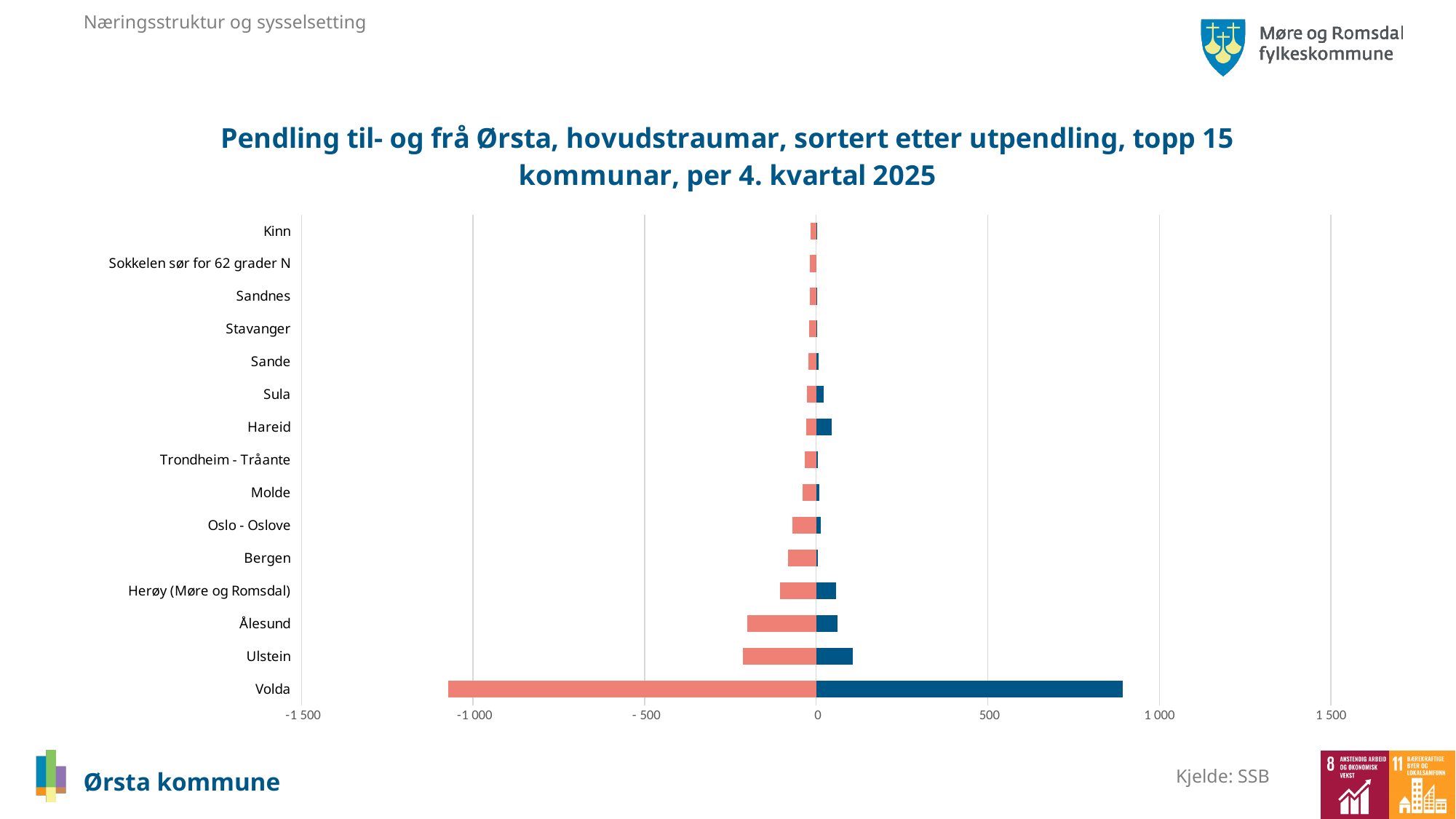
Which has the larger blue (inbound) bar, Volda or Ulstein? Volda What kind of chart is shown on the slide? bar chart Which municipality is listed at the top of the chart's vertical axis? Kinn Which municipality has the largest outbound commuting (longest red bar) in the chart? Volda Is the red (outbound) value for Ulstein greater or less than -500? greater Is the blue (inbound) value for Volda greater or less than 1 000? less Which has the larger blue (inbound) bar, Ulstein or Ålesund? Ulstein Which municipality has the largest inbound commuting (longest blue bar) in the chart? Volda What is the title of the chart? Pendling til- og frå Ørsta, hovudstraumar, sortert etter utpendling, topp 15 kommunar, per 4. kvartal 2025 Is the red (outbound) value for Volda greater or less than -1 000? less How many municipalities (categories) are listed on the vertical axis of the chart? 15